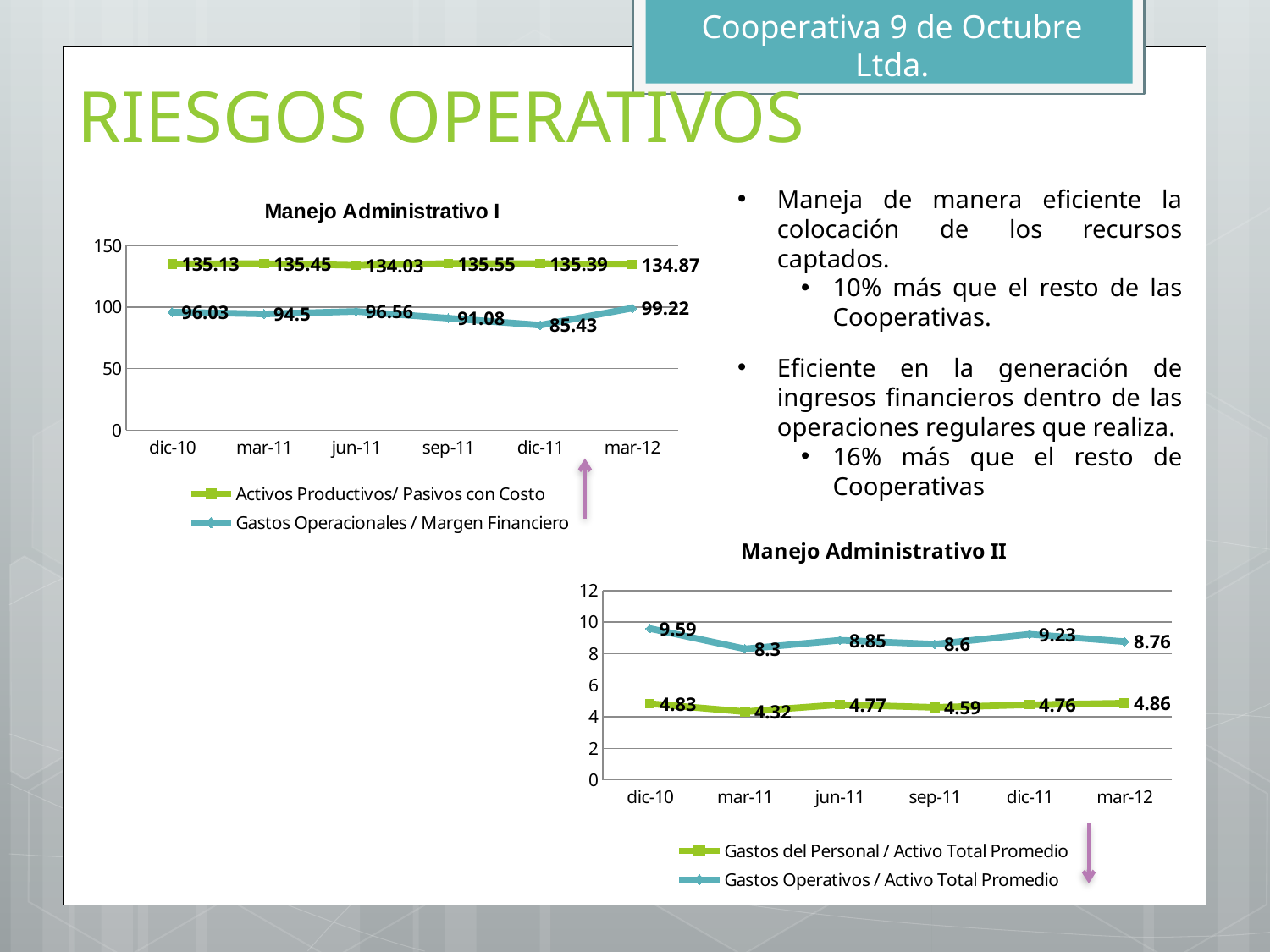
In the 'Manejo Administrativo I' chart, how many series does the legend list? 2 In the 'Manejo Administrativo I' chart, what is the difference between Activos Productivos/ Pasivos con Costo and Gastos Operacionales / Margen Financiero at mar-12? 35.65 In the 'Manejo Administrativo II' chart, what is the value of Gastos del Personal / Activo Total Promedio at mar-11? 4.32 In the 'Manejo Administrativo II' chart, what is the difference between Gastos Operativos / Activo Total Promedio at dic-10 and at mar-11? 1.29 In the 'Manejo Administrativo II' chart, how many periods are shown on the x axis? 6 What type of chart is 'Manejo Administrativo I'? Line chart In the 'Manejo Administrativo I' chart, what is the value of Activos Productivos/ Pasivos con Costo at sep-11? 135.55 In the 'Manejo Administrativo II' chart, what is the value of Gastos Operativos / Activo Total Promedio at dic-10? 9.59 In the 'Manejo Administrativo I' chart, what is the value of Gastos Operacionales / Margen Financiero at dic-11? 85.43 In the 'Manejo Administrativo II' chart, which is larger at jun-11: Gastos Operativos / Activo Total Promedio or Gastos del Personal / Activo Total Promedio? Gastos Operativos / Activo Total Promedio In the 'Manejo Administrativo II' chart, at which period is Gastos del Personal / Activo Total Promedio highest? mar-12 In the 'Manejo Administrativo I' chart, at which period is Gastos Operacionales / Margen Financiero lowest? dic-11